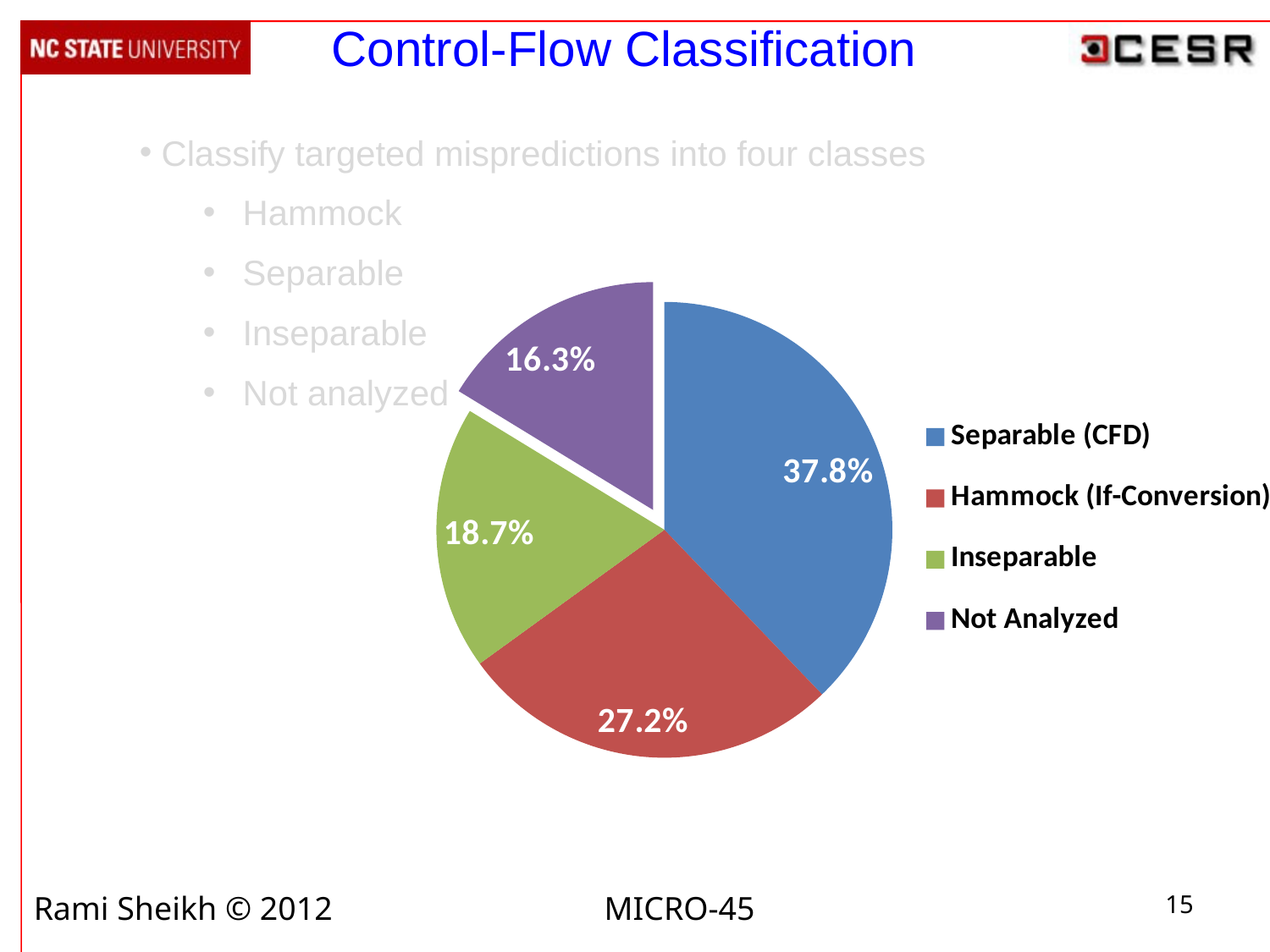
Which slice is pulled out (exploded) from the rest of the pie? Not Analyzed Which category has the smallest slice of the pie? Not Analyzed Which category has the largest slice of the pie? Separable (CFD) What is the value shown for Inseparable? 18.7% Which is larger, the Hammock (If-Conversion) slice or the Inseparable slice? Hammock (If-Conversion) What is the value shown for Not Analyzed? 16.3% What is the difference between the Inseparable and Not Analyzed shares? 2.4% What is the value shown for Hammock (If-Conversion)? 27.2% How many categories does the legend list? 4 What is the difference between the Separable (CFD) and Hammock (If-Conversion) shares? 10.6% What kind of chart is shown on the slide? pie chart What share of the pie does Separable (CFD) take? 37.8%